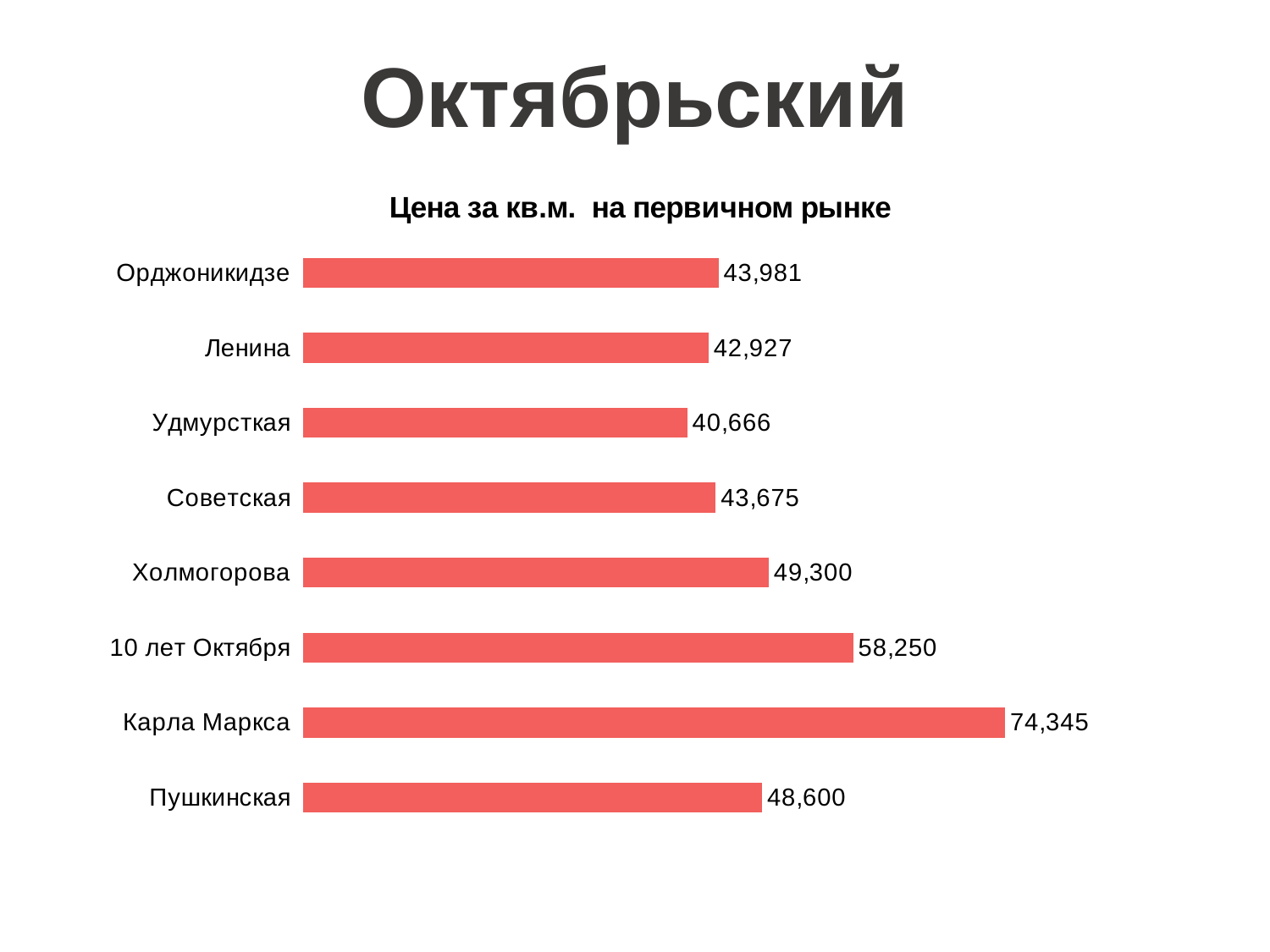
Which is larger, the value for 10 лет Октября or the value for Пушкинская? 10 лет Октября What kind of chart is shown on the slide? Bar chart Which category has the lowest value? Удмурсткая Which is larger, the value for Холмогорова or the value for Советская? Холмогорова What is the value for Карла Маркса? 74,345 What is the difference between the values for Карла Маркса and 10 лет Октября? 16,095 What is the title of the chart? Цена за кв.м. на первичном рынке Which category has the highest value? Карла Маркса What is the value for Удмурсткая? 40,666 What is the value for Холмогорова? 49,300 How many categories are shown in the chart? 8 What is the difference between the values for Пушкинская and Ленина? 5,673